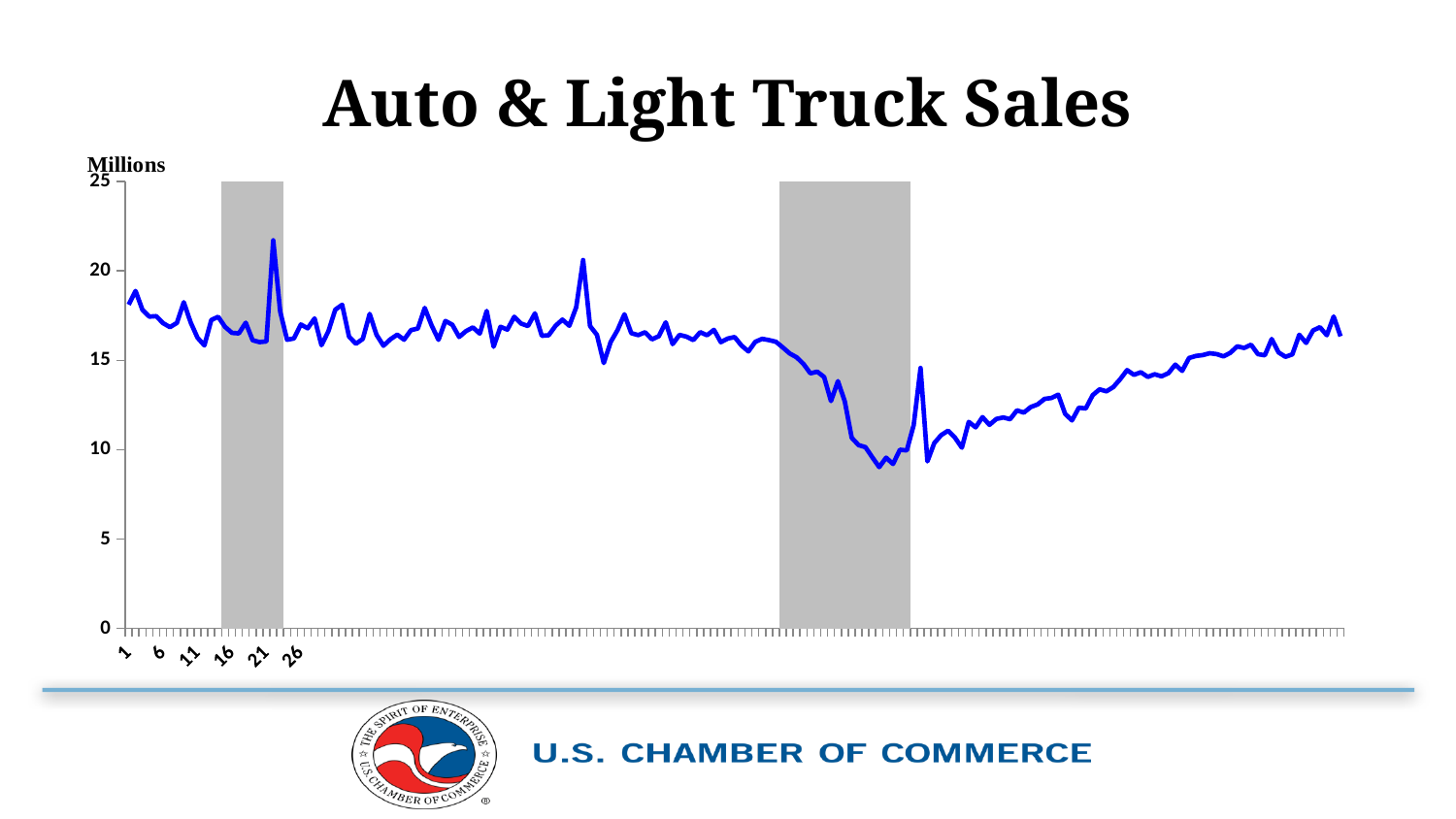
What kind of chart is shown on the slide? line chart What unit label is shown above the vertical axis? Millions Is the value at x-axis point 16 greater or less than 10? greater Does the line rise or fall within the second (right-hand) shaded region? fall After the second shaded region, does the line generally rise or fall toward the right end of the chart? rise Is the value at x-axis point 1 greater or less than 15? greater Is the highest point of the line greater or less than 20? greater What is the title of the chart? Auto & Light Truck Sales What is the highest value shown on the vertical axis? 25 How many gray shaded regions are drawn on the chart? 2